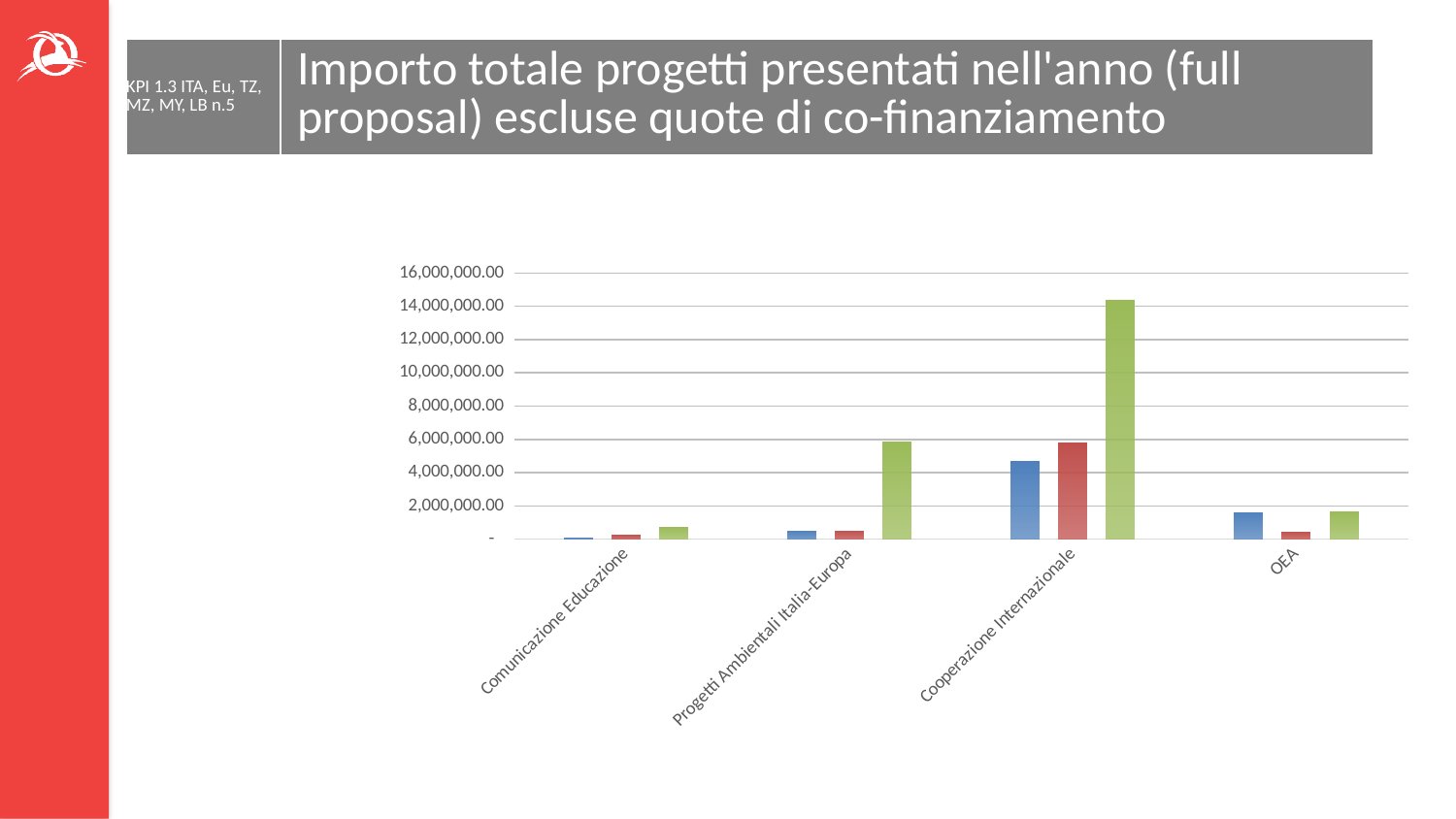
Which category has the tallest bar in the chart? Cooperazione Internazionale How many categories are shown on the x axis of the chart? 4 Which is larger: the green bar for Cooperazione Internazionale or the green bar for Progetti Ambientali Italia-Europa? Cooperazione Internazionale What kind of chart is shown on the slide? bar chart What is the title of the slide containing the chart? Importo totale progetti presentati nell'anno (full proposal) escluse quote di co-finanziamento Which category has the lowest bars overall in the chart? Comunicazione Educazione What is the highest value shown on the y axis of the chart? 16,000,000.00 Is the value of the blue bar for Cooperazione Internazionale greater or less than 4,000,000.00? greater Is the value of the red bar for OEA greater or less than 2,000,000.00? less Which is larger for OEA: the blue bar or the red bar? the blue bar Is the value of the green bar for Cooperazione Internazionale greater or less than 14,000,000.00? greater